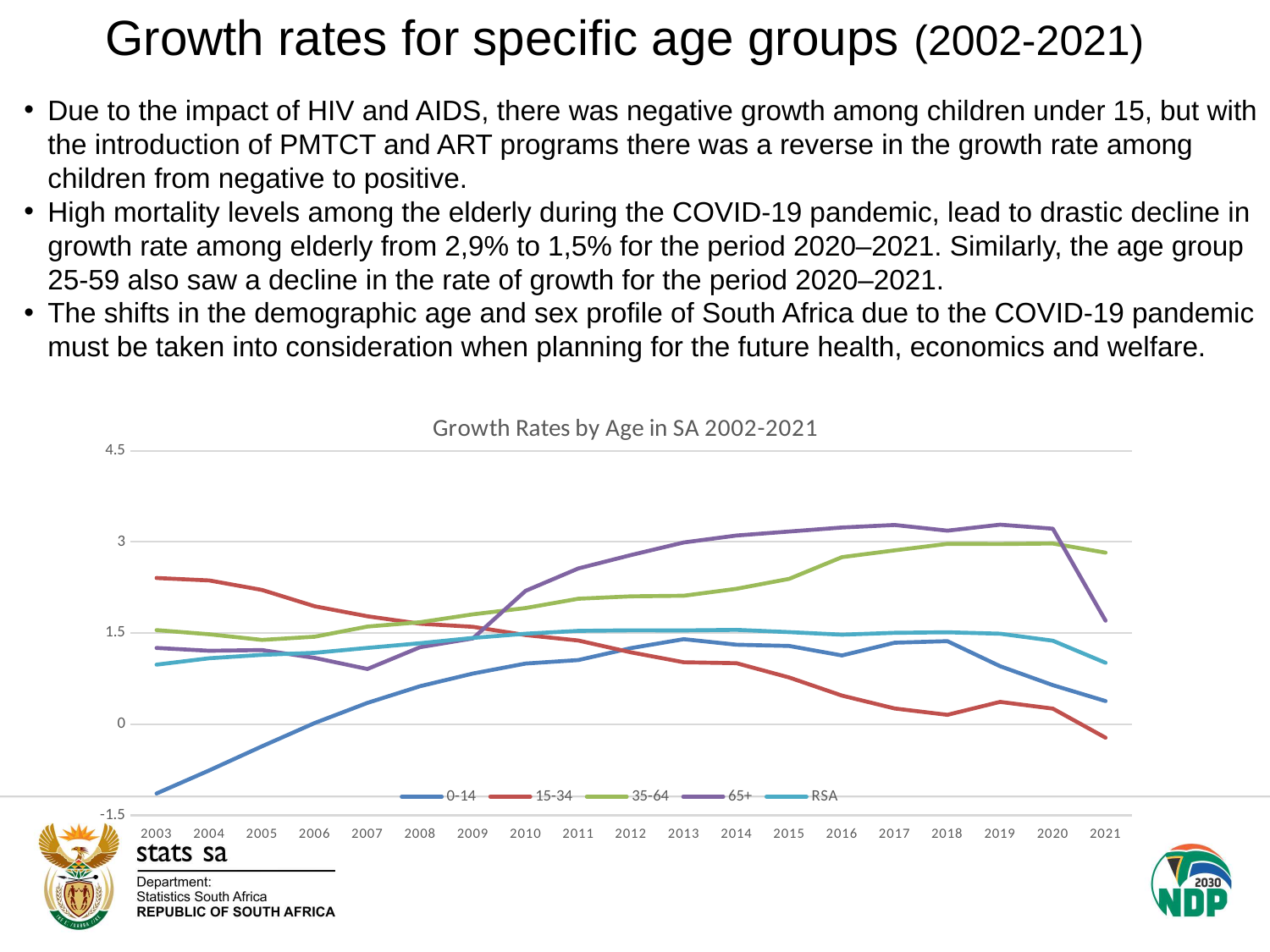
In 2021, which series has the larger value, 65+ or 0-14? 65+ Which series has the lowest value in 2021? 15-34 How many series does the chart legend list? 5 How many years are shown along the x axis of the chart? 19 Is the value for the 0-14 series in 2003 greater or less than 0? less Is the value for the 15-34 series in 2021 greater or less than 0? less Is the value for the 65+ series in 2007 greater or less than 1.5? less Which series is plotted with the blue line in the chart? 0-14 What is the title of the chart? Growth Rates by Age in SA 2002-2021 What kind of chart is shown on the slide? line chart Which series has the highest value in 2019? 65+